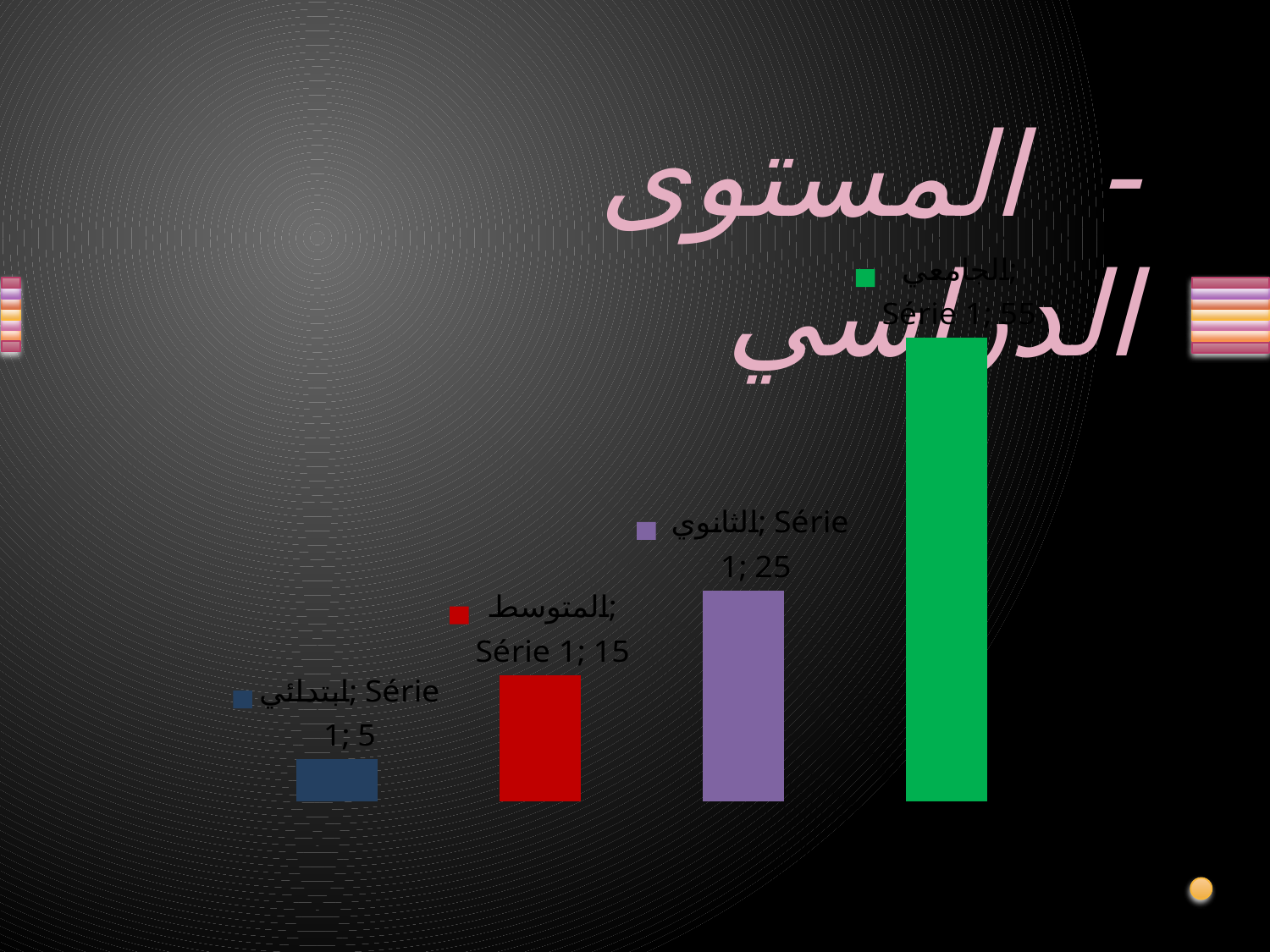
Do the values rise or fall from left to right across the bars? rise What series name appears in the data labels? Série 1 Which is larger, the value for المتوسط or the value for ابتدائي? المتوسط What is the value for الثانوي? 25 What is the value for المتوسط? 15 What is the value for ابتدائي? 5 What is the difference between the values for الثانوي and المتوسط? 10 Which category has the highest value? الجامعي Which category has the lowest value? ابتدائي What is the value for الجامعي? 55 What kind of chart is shown on the slide? bar chart How many bars are plotted in the chart? 4